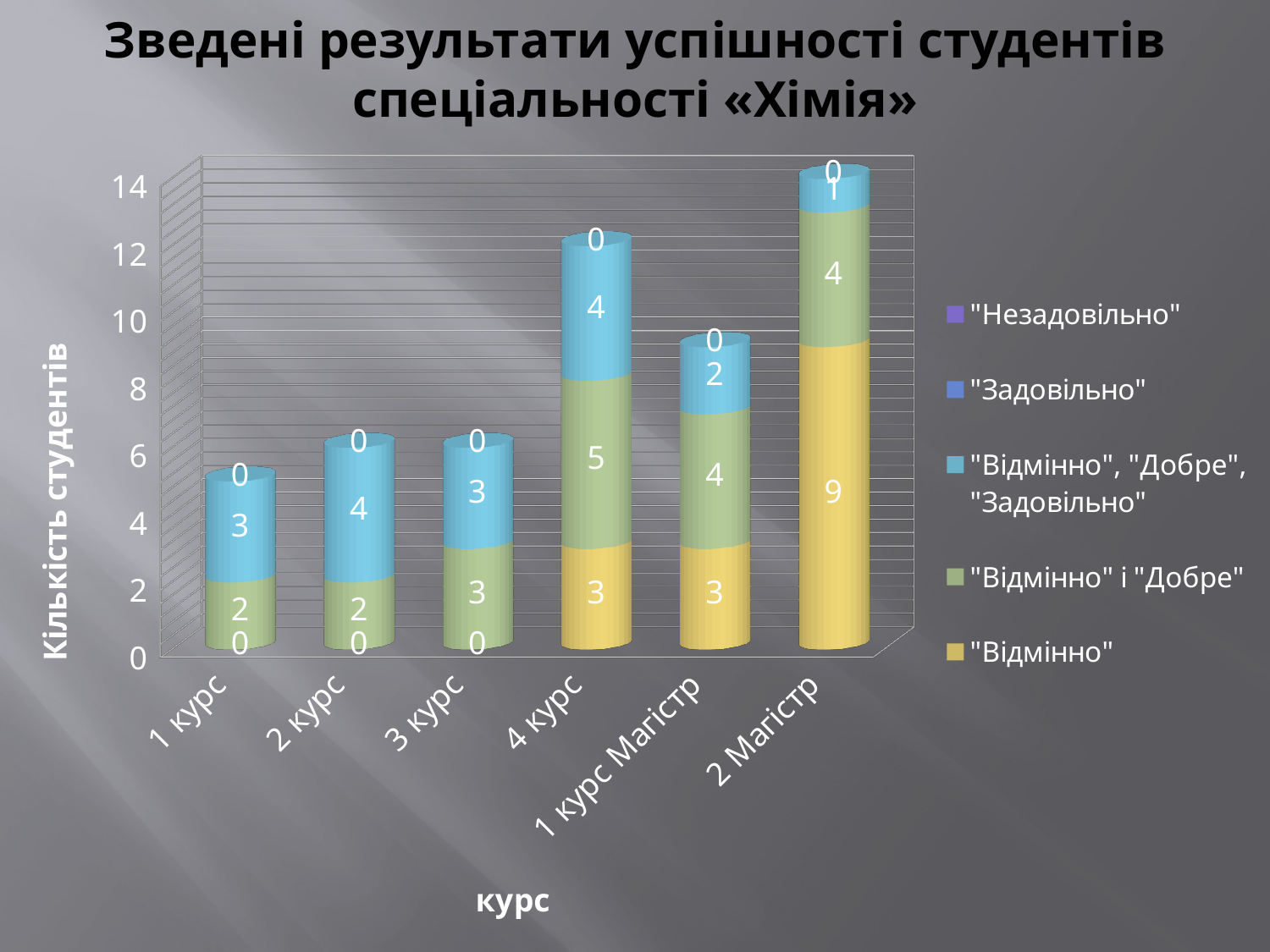
What is the total of the stacked bar for 2 Магістр? 14 Which category has the tallest stacked bar? 2 Магістр How many categories are shown on the x axis? 6 What is the value of "Відмінно", "Добре", "Задовільно" for 2 курс? 4 How many series does the legend list? 5 What is the difference between the "Відмінно" values for 2 Магістр and 1 курс Магістр? 6 What is the value of "Відмінно" for 2 Магістр? 9 What is the total of the stacked bar for 4 курс? 12 What is the value of "Відмінно" for 1 курс Магістр? 3 Which category has the shortest stacked bar? 1 курс Which has a larger "Відмінно" і "Добре" value, 4 курс or 1 курс Магістр? 4 курс What is the value of "Відмінно" і "Добре" for 4 курс? 5